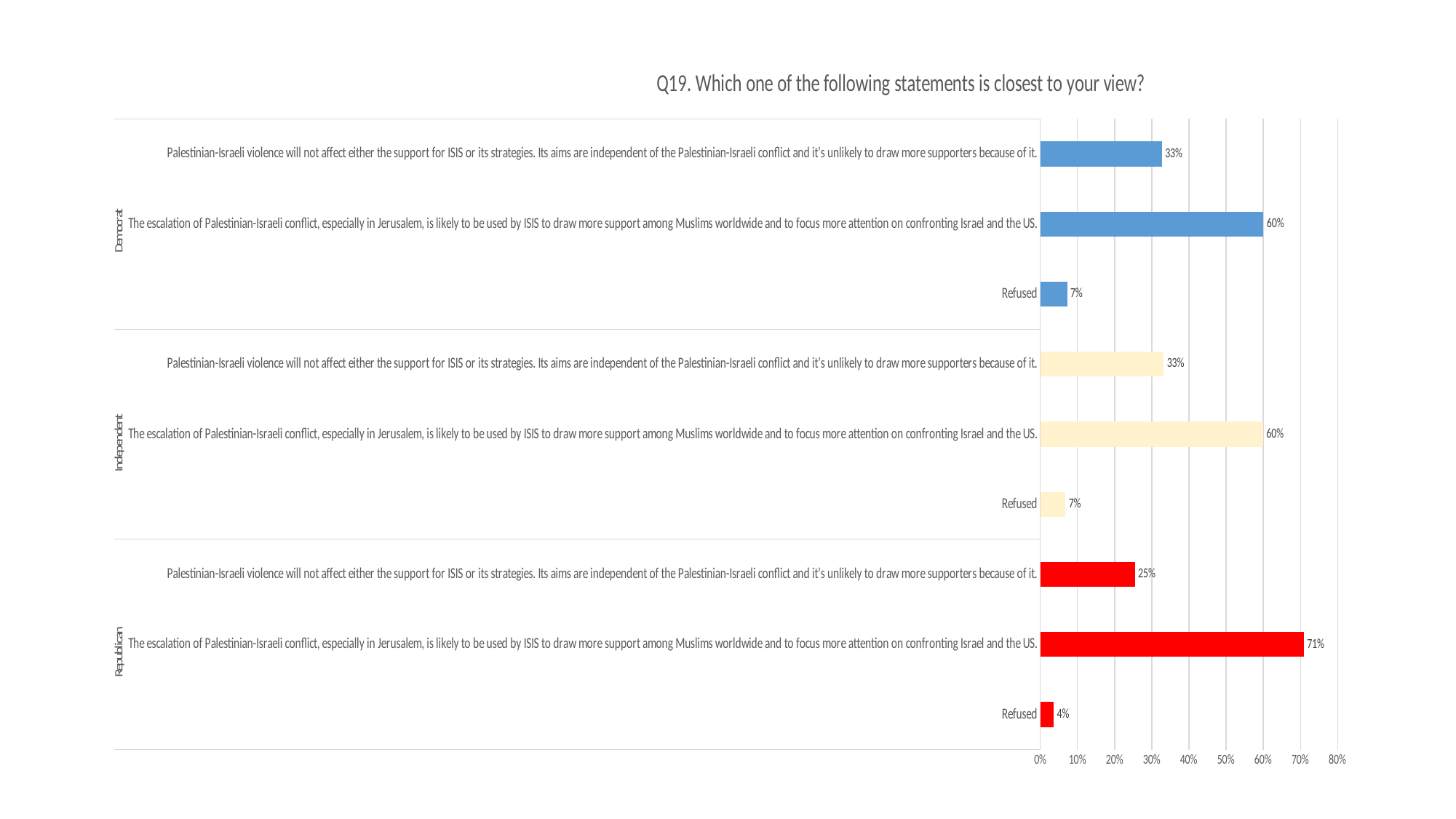
Which group has the highest percentage for the statement that the escalation of the conflict is likely to be used by ISIS to draw more support? Republican What is the difference between the Republican and Democrat percentages for the statement that the escalation of the conflict is likely to be used by ISIS to draw more support? 11 percentage points What colour are the bars for the Republican group? Red What percentage of Republicans chose the statement that the escalation of Palestinian-Israeli conflict is likely to be used by ISIS to draw more support? 71% What percentage of Independents chose the statement that Palestinian-Israeli violence will not affect support for ISIS or its strategies? 33% What kind of chart is shown on the slide? Bar chart Which group has the lowest percentage of refusals? Republican What percentage of Republicans refused to answer? 4% Is the Republican value for the statement that the escalation of the conflict is likely to be used by ISIS greater or less than 70%? greater How many bars are plotted in the chart? 9 What percentage of Democrats refused to answer? 7% Which is larger: the Democrat percentage or the Republican percentage for the statement that Palestinian-Israeli violence will not affect support for ISIS? Democrat